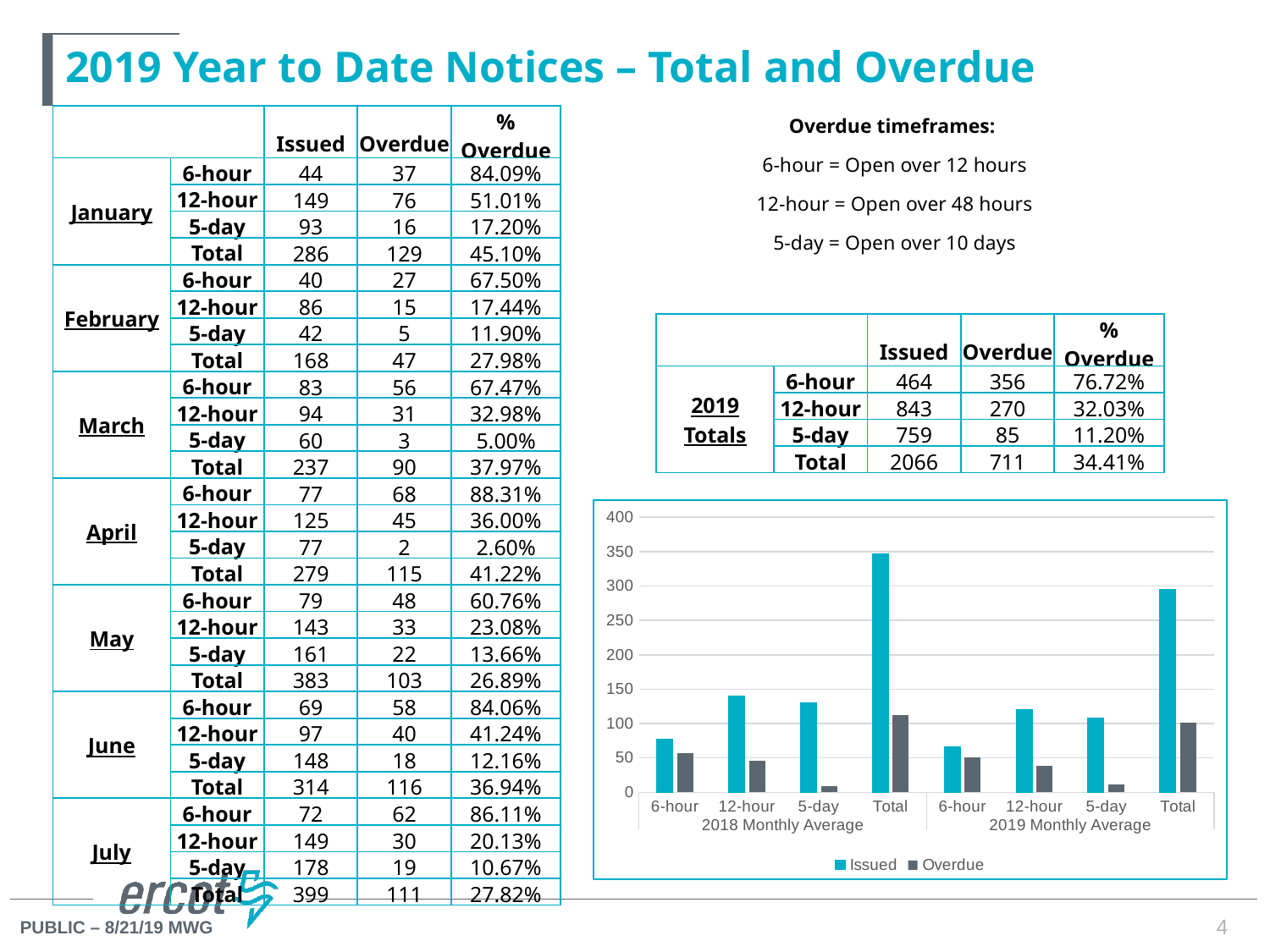
Which is larger: the Issued value for Total under 2018 Monthly Average or the Issued value for Total under 2019 Monthly Average? Total under 2018 Monthly Average Which category has the tallest Issued bar in the chart? Total (2018 Monthly Average) What kind of chart is shown on the slide? bar chart Is the Overdue value for 5-day under 2018 Monthly Average greater or less than 50? less Is the Overdue value for 6-hour under 2019 Monthly Average greater or less than 100? less How many series does the chart legend list? 2 Is the Issued value for 12-hour under 2018 Monthly Average greater or less than 100? greater How many categories are shown along the x axis of the chart? 8 What are the two series named in the chart legend? Issued and Overdue Which is larger: the Issued value for 12-hour under 2018 Monthly Average or the Issued value for 12-hour under 2019 Monthly Average? 12-hour under 2018 Monthly Average